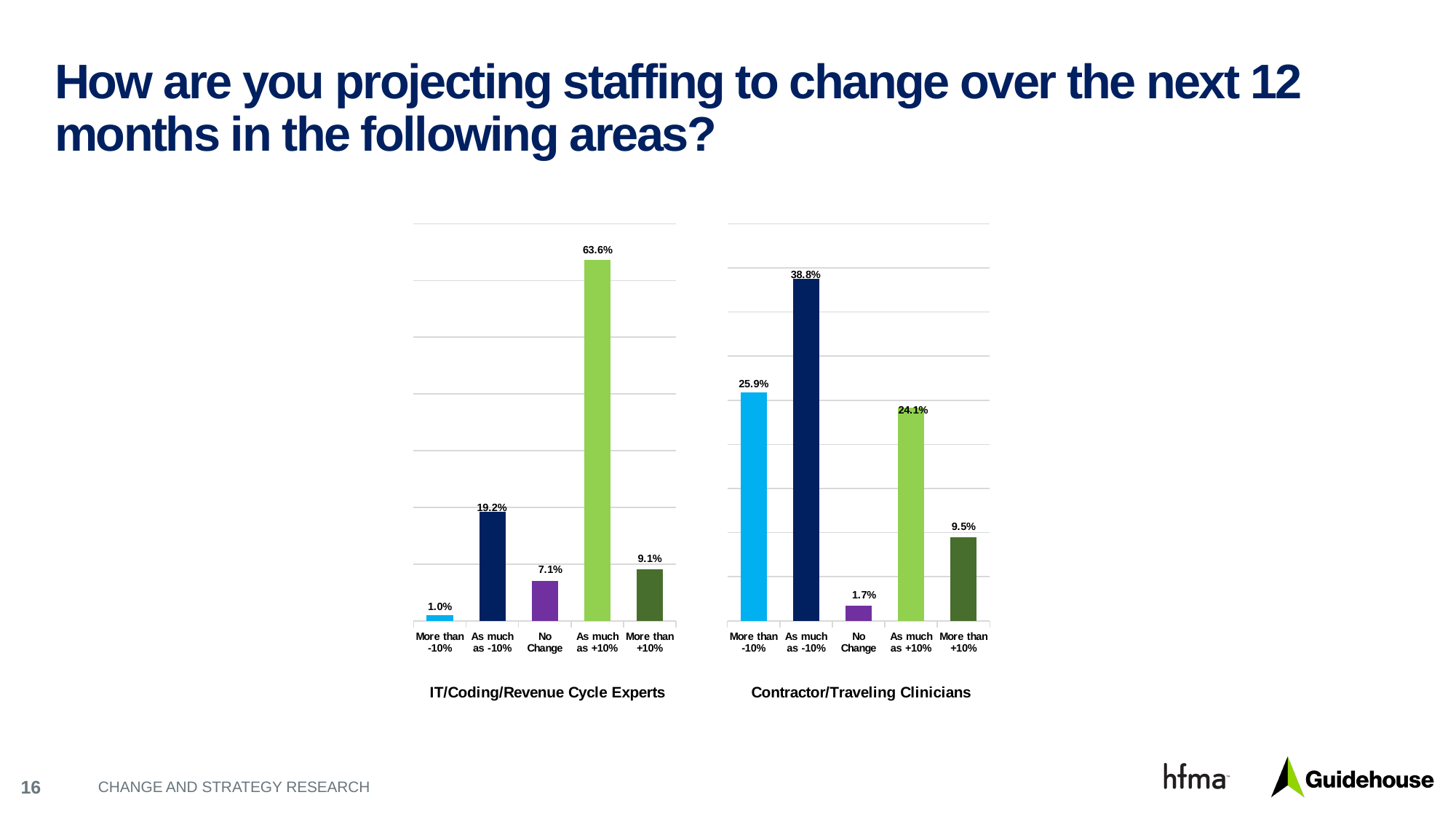
In the IT/Coding/Revenue Cycle Experts chart, what is the value for 'No Change'? 7.1% In the IT/Coding/Revenue Cycle Experts chart, what is the value for 'As much as +10%'? 63.6% In the Contractor/Traveling Clinicians chart, which category has the highest value? As much as -10% In the Contractor/Traveling Clinicians chart, what is the difference between 'As much as -10%' and 'As much as +10%'? 14.7% Which is larger: 'More than +10%' in the IT/Coding/Revenue Cycle Experts chart or 'More than +10%' in the Contractor/Traveling Clinicians chart? Contractor/Traveling Clinicians How many categories are shown in the IT/Coding/Revenue Cycle Experts chart? 5 What type of chart is used for Contractor/Traveling Clinicians? Bar chart In the Contractor/Traveling Clinicians chart, which category has the lowest value? No Change In the IT/Coding/Revenue Cycle Experts chart, which category has the lowest value? More than -10% In the Contractor/Traveling Clinicians chart, what is the value for 'More than -10%'? 25.9% In the IT/Coding/Revenue Cycle Experts chart, what is the difference between 'As much as +10%' and 'As much as -10%'? 44.4% How many charts are shown on the slide? 2